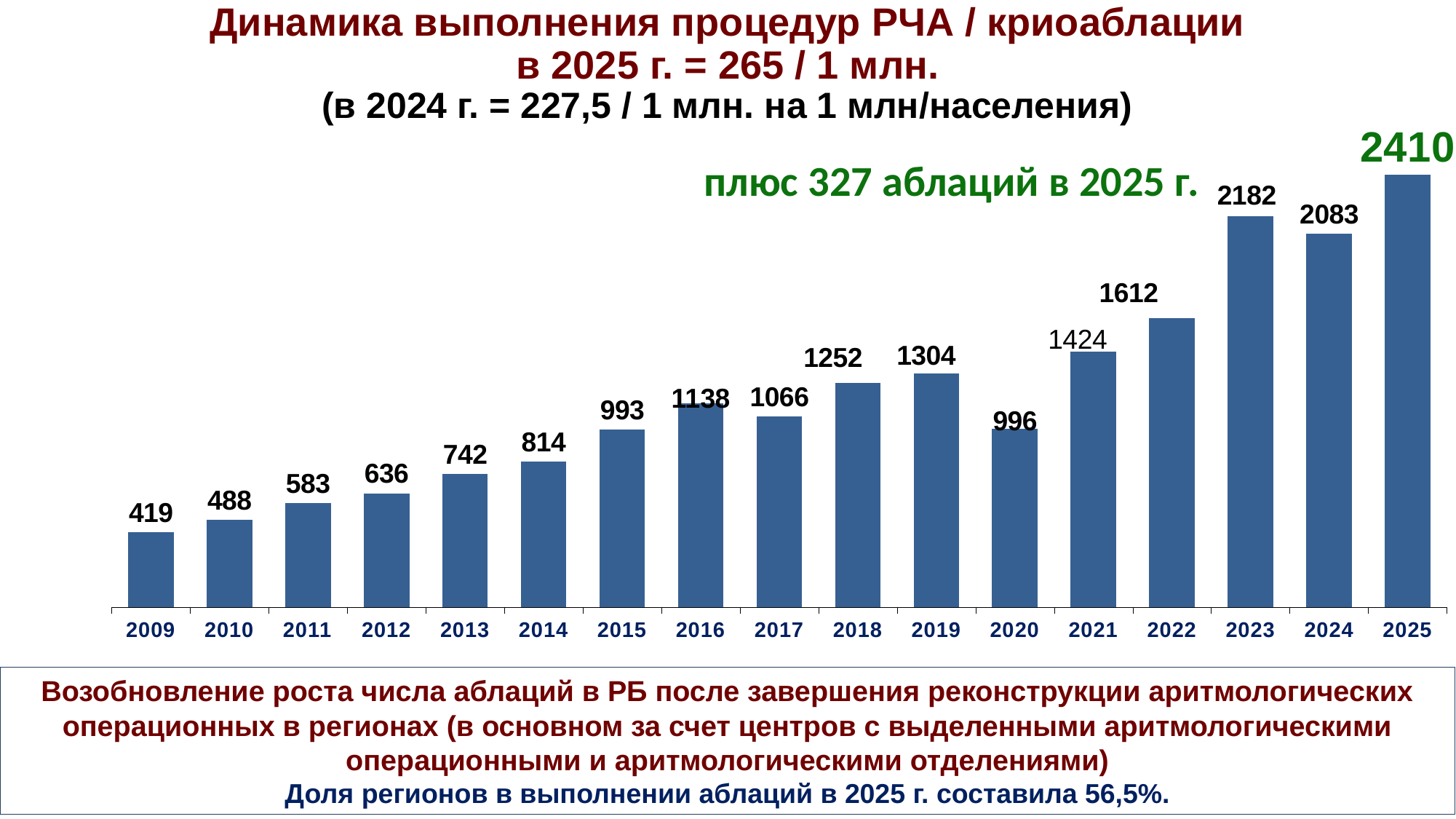
Which year has the lowest value? 2009 What is the value for 2016? 1138 What is the value for 2025? 2410 What is the value for 2009? 419 What is the value for 2020? 996 How many years are shown on the x axis? 17 What is the difference between the values for 2025 and 2024? 327 Which is larger, the value for 2023 or the value for 2024? 2023 Which is larger, the value for 2019 or the value for 2020? 2019 What kind of chart is shown on the slide? Bar chart Which year has the highest value? 2025 What is the difference between the values for 2023 and 2022? 570